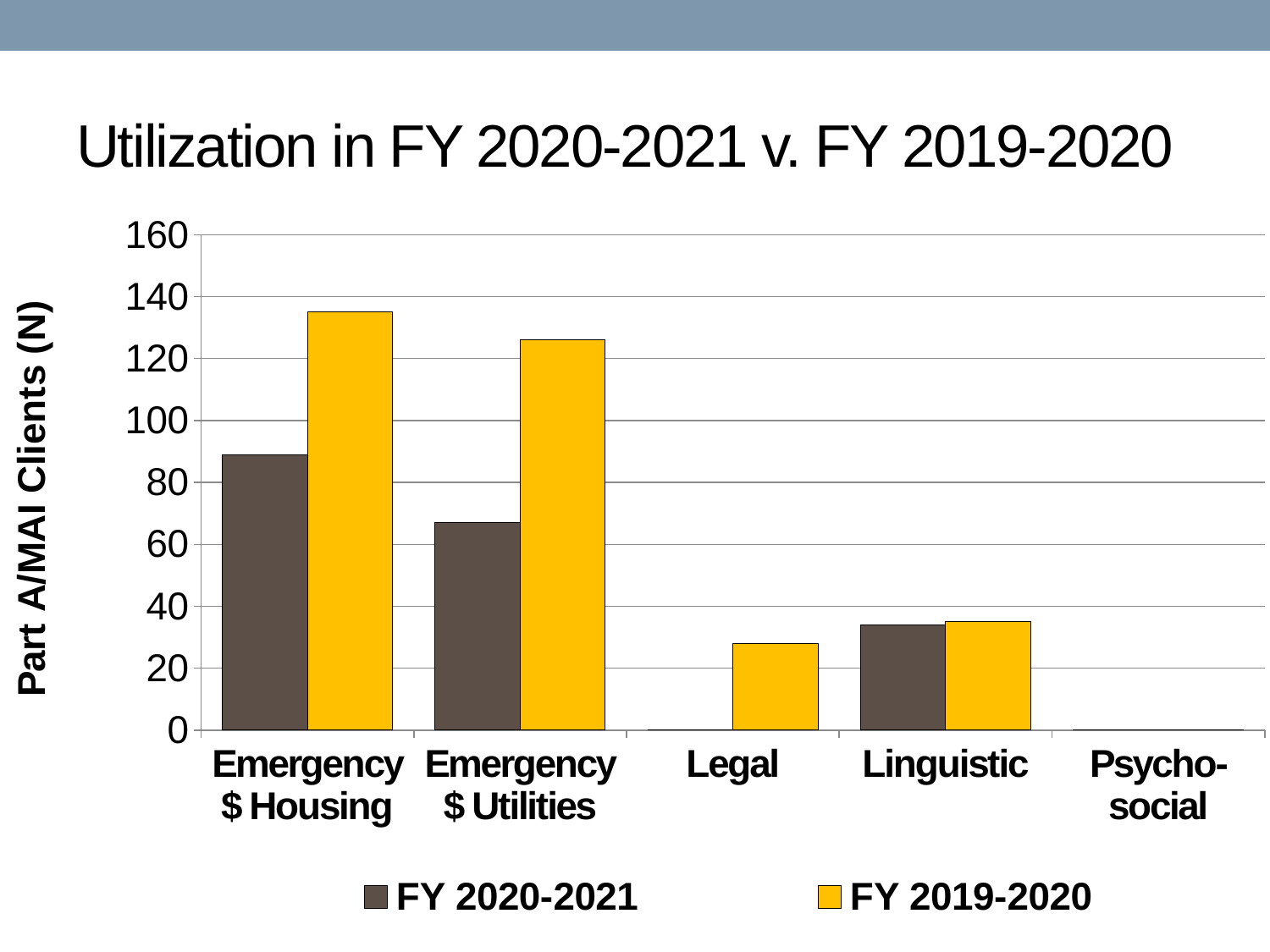
Is the FY 2020-2021 value for Emergency $ Utilities greater or less than 60? greater For Emergency $ Utilities, which series has the larger value, FY 2020-2021 or FY 2019-2020? FY 2019-2020 How many series does the legend list? 2 What is the title of the chart? Utilization in FY 2020-2021 v. FY 2019-2020 Is the FY 2019-2020 value for Legal greater or less than 40? less Is the FY 2020-2021 value for Emergency $ Housing greater or less than 100? less How many categories are shown on the x axis? 5 Which is larger: the FY 2019-2020 value for Legal or the FY 2019-2020 value for Emergency $ Utilities? Emergency $ Utilities Which category has the highest FY 2019-2020 value? Emergency $ Housing What kind of chart is shown on the slide? bar chart Which category has the highest FY 2020-2021 value? Emergency $ Housing